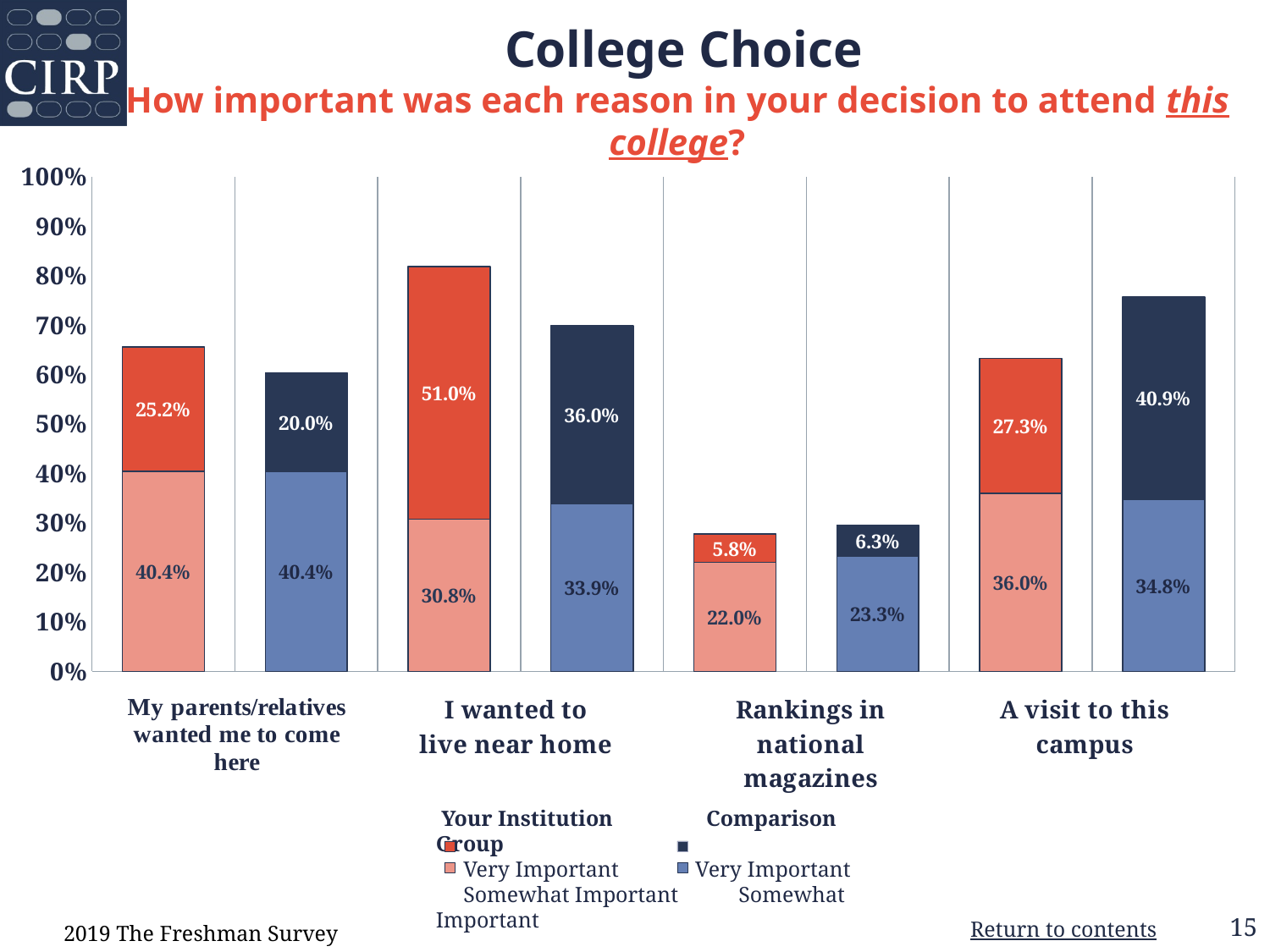
What percentage of the Comparison Group rated 'A visit to this campus' as Very Important? 40.9% What percentage of Your Institution students rated 'Rankings in national magazines' as Somewhat Important? 22.0% What is the difference between the Your Institution and Comparison Group Very Important percentages for 'I wanted to live near home'? 15.0% Which reason has the lowest Very Important percentage for Your Institution? Rankings in national magazines Is the total stacked bar for Your Institution on 'Rankings in national magazines' greater or less than 30%? less What percentage of Your Institution students rated 'I wanted to live near home' as Very Important? 51.0% What is the total stacked percentage (Very Important plus Somewhat Important) for Your Institution on 'I wanted to live near home'? 81.8% Which reason has the highest Very Important percentage for Your Institution? I wanted to live near home How many reasons (categories) are shown along the x axis? 4 What kind of chart is shown on the slide? stacked bar chart What is the total stacked percentage for the Comparison Group on 'A visit to this campus'? 75.7% For 'A visit to this campus', which group has the larger Very Important percentage, Your Institution or the Comparison Group? Comparison Group